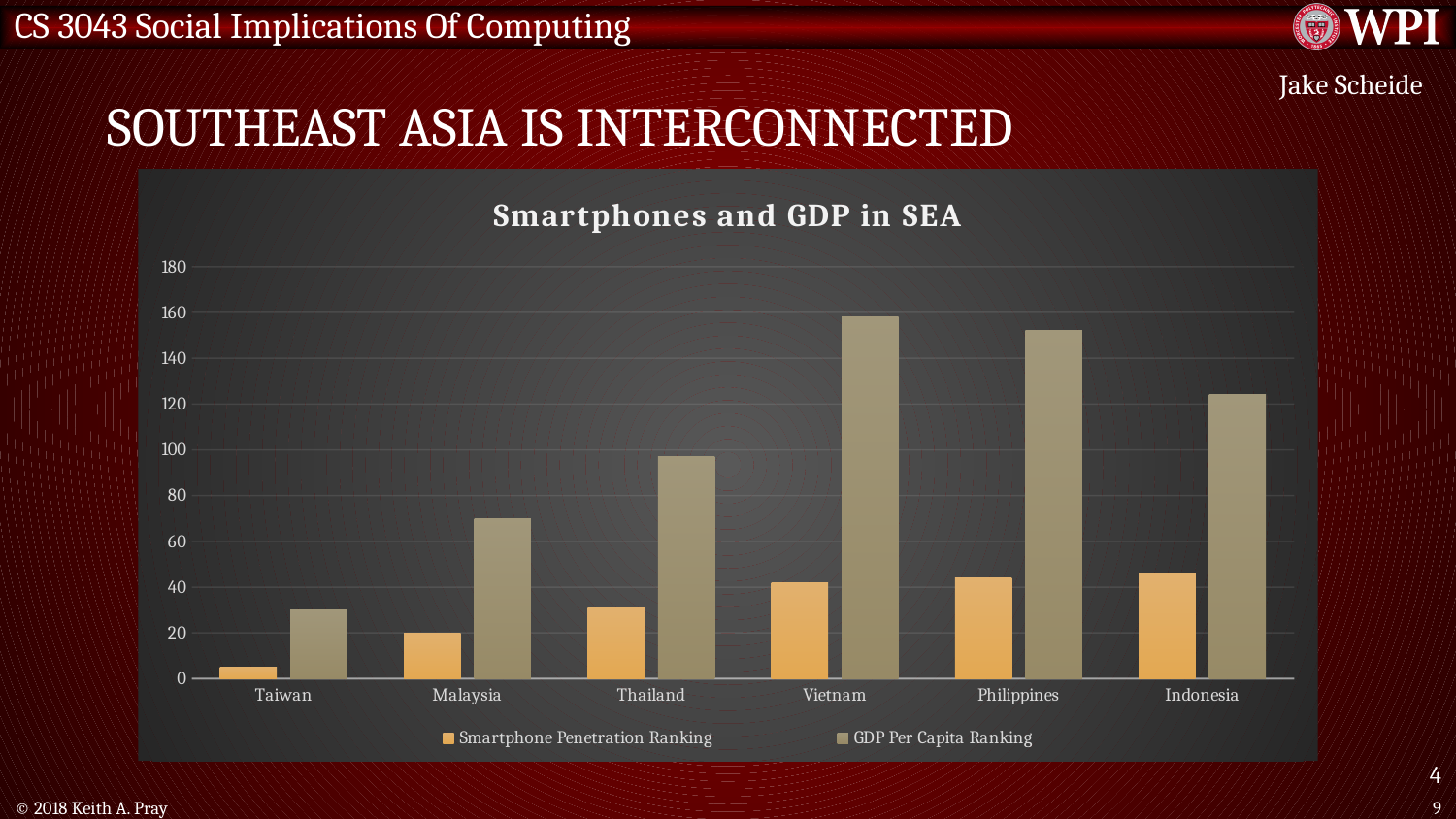
Is the GDP Per Capita Ranking value for Vietnam greater or less than 140? greater Is the GDP Per Capita Ranking value for Taiwan greater or less than 40? less Which country has the lowest GDP Per Capita Ranking bar? Taiwan What kind of chart is shown on the slide? bar chart How many countries are shown on the x axis? 6 Do the Smartphone Penetration Ranking values rise or fall from Taiwan to Indonesia along the x axis? rise How many series does the legend list? 2 Which country has the lowest Smartphone Penetration Ranking bar? Taiwan Is the GDP Per Capita Ranking value for Malaysia greater or less than 60? greater Which is larger for Thailand: the Smartphone Penetration Ranking or the GDP Per Capita Ranking? GDP Per Capita Ranking What is the title of the chart? Smartphones and GDP in SEA